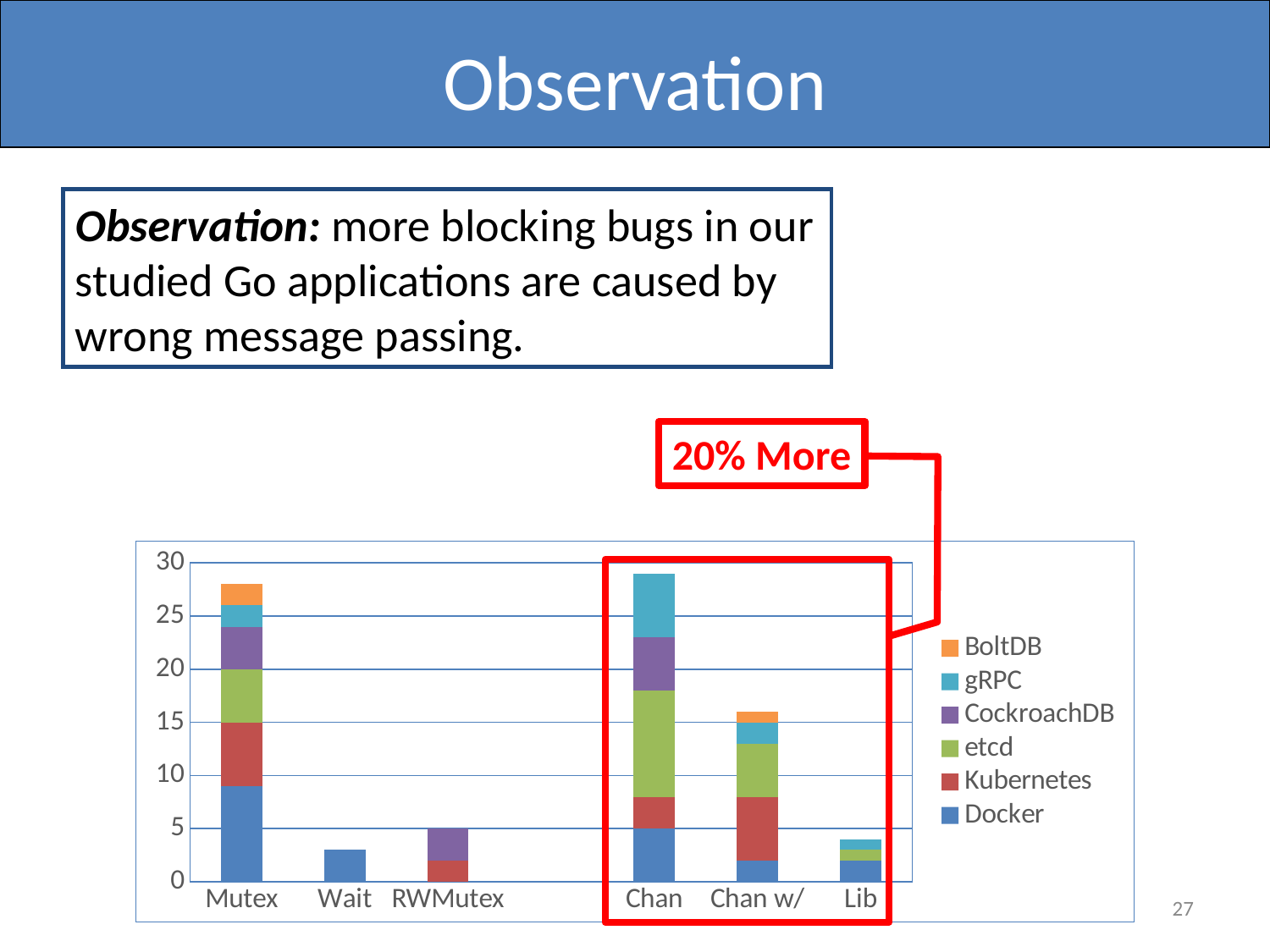
Is the total value for Lib greater or less than 5? less Is the total value for Mutex greater or less than 25? greater Is the total value for Wait greater or less than 5? less Which has a larger total, Mutex or Chan w/? Mutex What text is shown in the red callout box above the chart? 20% More What kind of chart is shown on the slide? stacked bar chart Which series is listed first (at the top) in the legend? BoltDB Which has a larger total, Wait or Chan? Chan How many labeled categories are shown on the x axis? 6 How many series does the legend list? 6